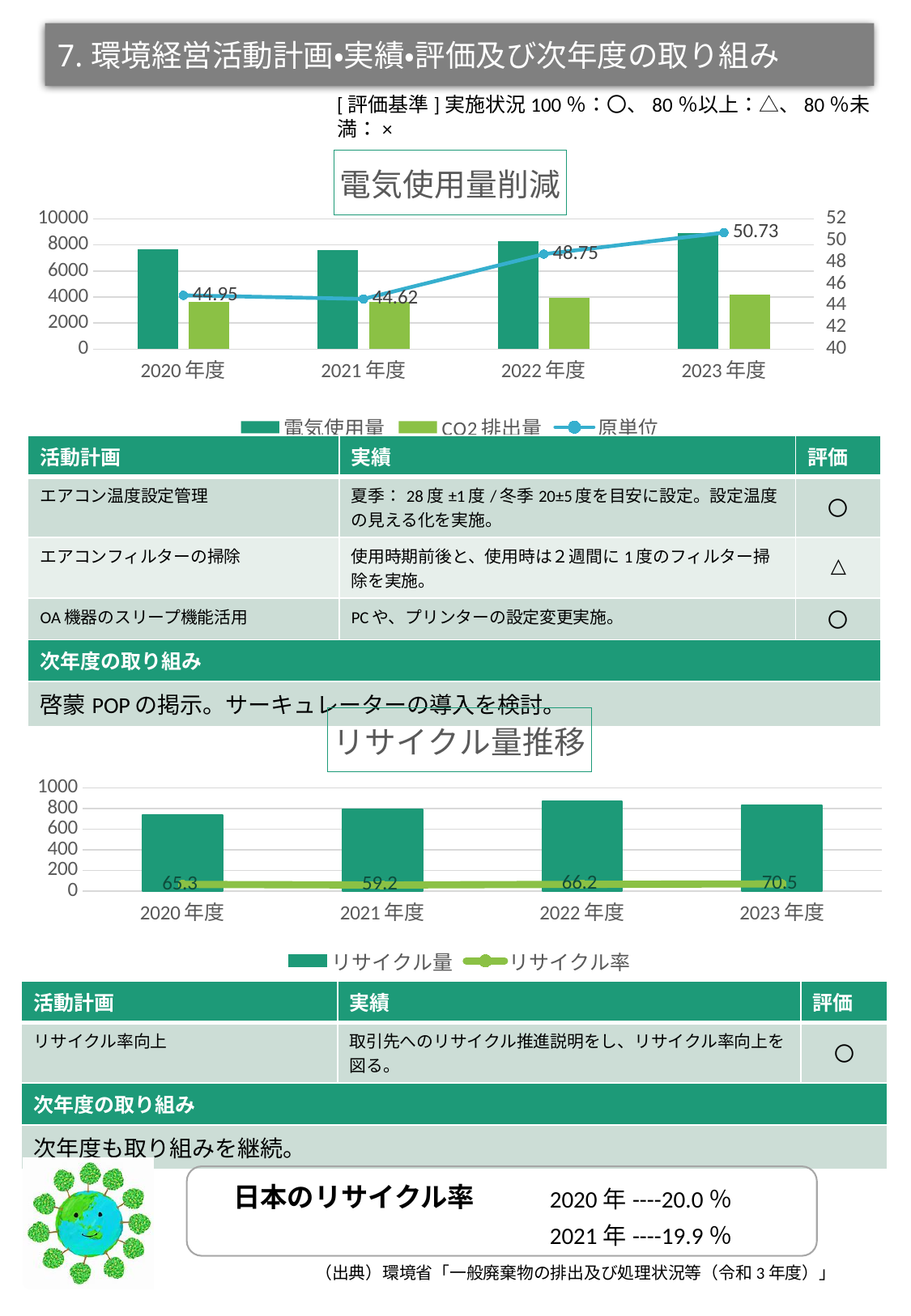
In the 電気使用量削減 chart, what is the 原単位 value for 2020年度? 44.95 In the リサイクル量推移 chart, what is the リサイクル率 value for 2021年度? 59.2 In the 電気使用量削減 chart, what is the difference between the 原単位 values for 2023年度 and 2022年度? 1.98 In the リサイクル量推移 chart, which year has the lowest リサイクル率? 2021年度 In the 電気使用量削減 chart, which year has the highest 原単位 value? 2023年度 In the リサイクル量推移 chart, what is the difference between the リサイクル率 values for 2023年度 and 2020年度? 5.2 In the 電気使用量削減 chart, is the 電気使用量 value for 2020年度 greater or less than 6000? greater In the 電気使用量削減 chart, how many series does the legend list? 3 In the 電気使用量削減 chart, which year has the lowest 原単位 value? 2021年度 In the 電気使用量削減 chart, what is the 原単位 value for 2023年度? 50.73 In the リサイクル量推移 chart, which year has the highest リサイクル率? 2023年度 In the リサイクル量推移 chart, how many years are shown on the x axis? 4